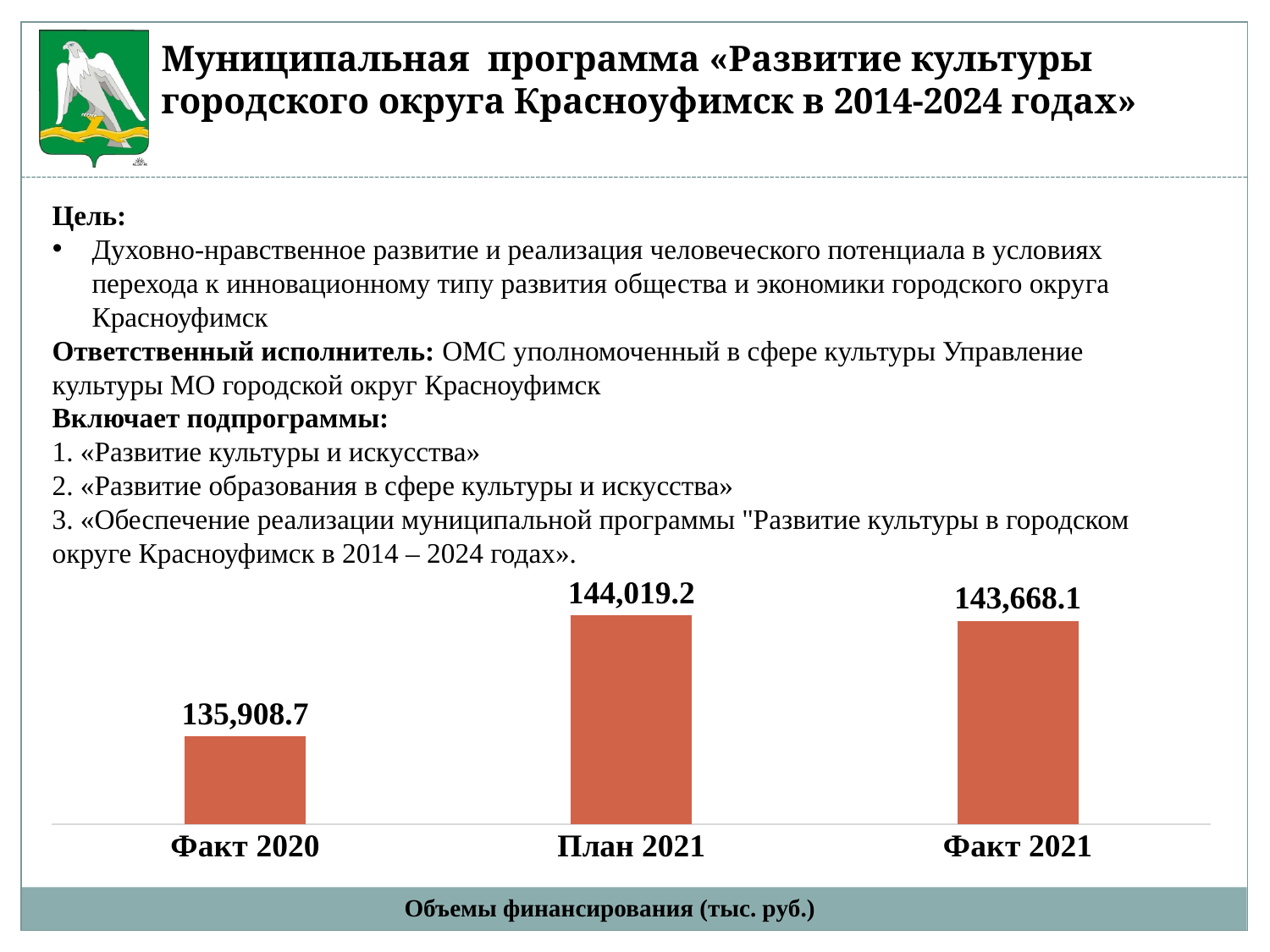
What is the difference between the values for План 2021 and Факт 2020? 8,110.5 What is the value for План 2021 in the chart? 144,019.2 What is the caption shown below the chart? Объемы финансирования (тыс. руб.) What is the value for Факт 2020 in the chart? 135,908.7 Which category has the lowest value in the chart? Факт 2020 What is the difference between the values for Факт 2021 and Факт 2020? 7,759.4 How many categories are shown in the chart? 3 What is the value for Факт 2021 in the chart? 143,668.1 Which is larger, the value for Факт 2021 or the value for Факт 2020? Факт 2021 What is the difference between the values for План 2021 and Факт 2021? 351.1 What kind of chart is shown on the slide? Bar chart Which category has the highest value in the chart? План 2021